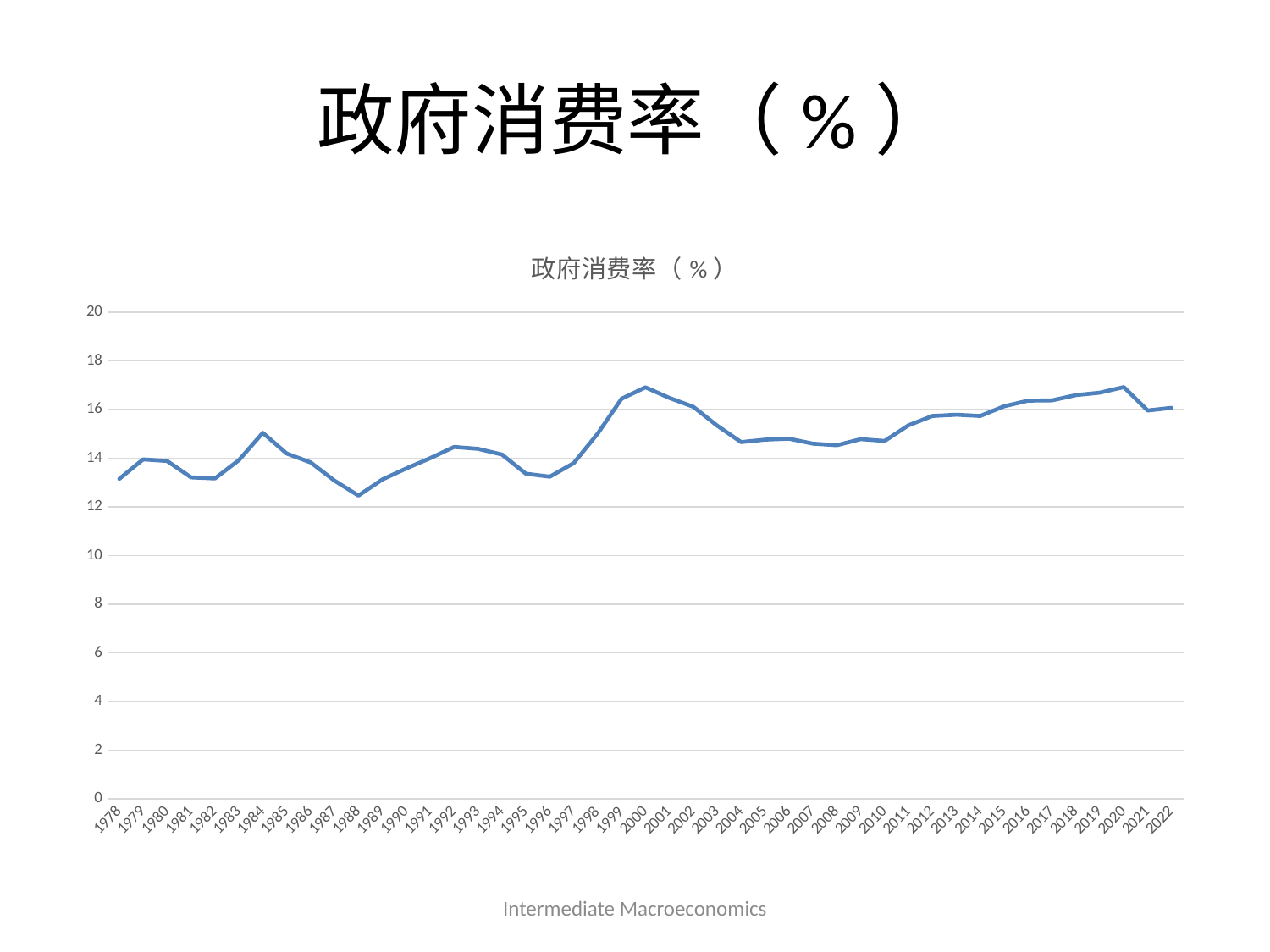
Is the value for 2019 greater or less than 16? greater Which year has the larger value, 1984 or 1988? 1984 Does the government consumption rate rise or fall from 1996 to 2000? rise Which year has the lowest government consumption rate in the chart? 1988 How many years are plotted on the x axis of the chart? 45 What is the title of the chart? 政府消费率（%） Is the value for 1988 greater or less than 14? less Is the value for 2000 greater or less than 16? greater What kind of chart is shown on the slide? line chart Which year has the larger value, 1978 or 2000? 2000